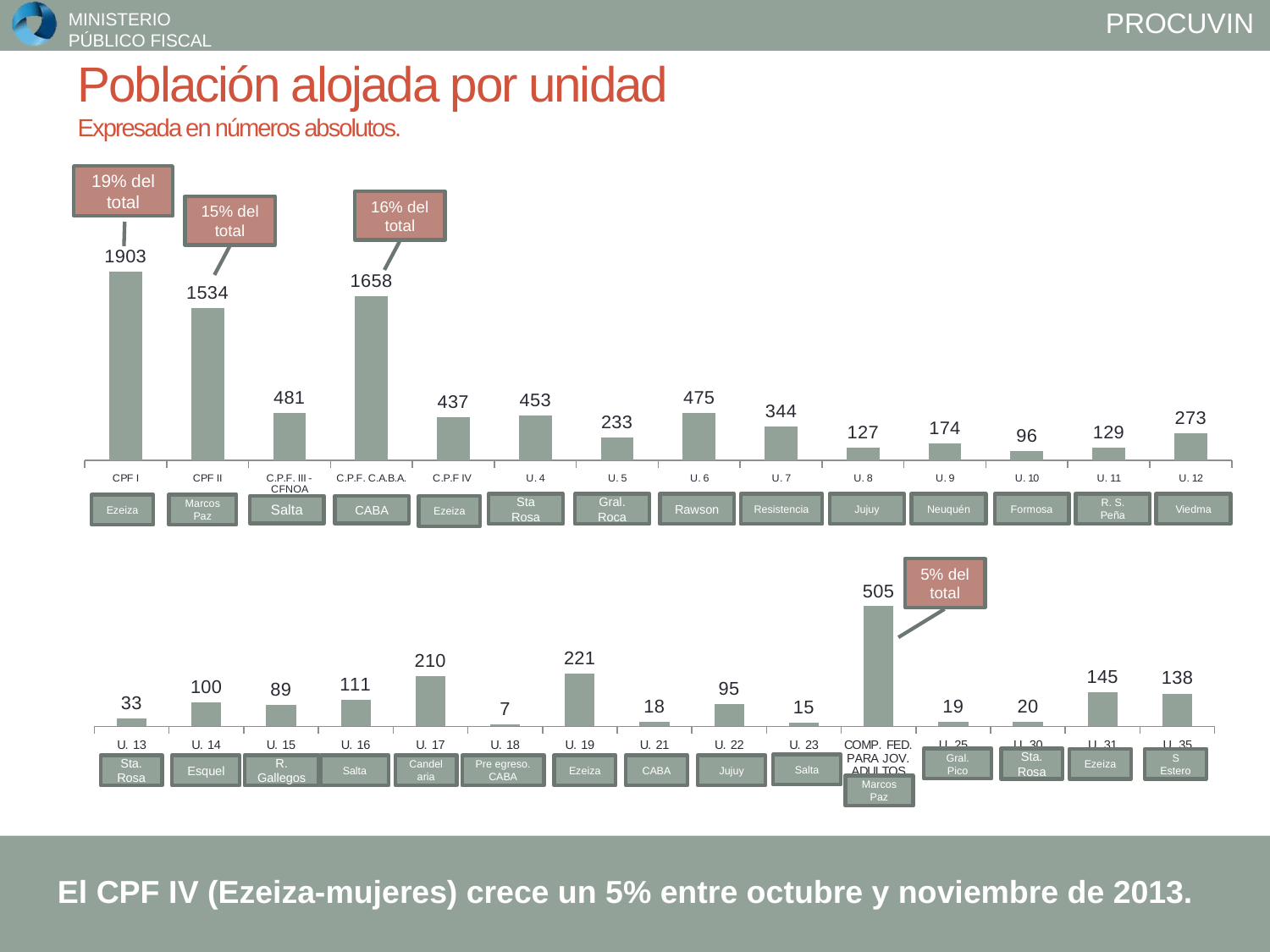
In the top chart, what is the value for U. 7? 344 In the bottom chart, what is the value for U. 19? 221 What type of chart is the top chart? Bar chart In the top chart, what is the value for CPF I? 1903 In the bottom chart, which category has the lowest value? U. 18 How many categories are shown in the bottom chart? 15 In the top chart, which category has the highest value? CPF I In the top chart, which is larger, the value for U. 4 or the value for U. 6? U. 6 In the bottom chart, which category has the highest value? COMP. FED. PARA JOV. ADULTOS In the top chart, which category has the lowest value? U. 10 In the top chart, what is the difference between the values for CPF I and CPF II? 369 In the bottom chart, what is the difference between the values for U. 31 and U. 35? 7